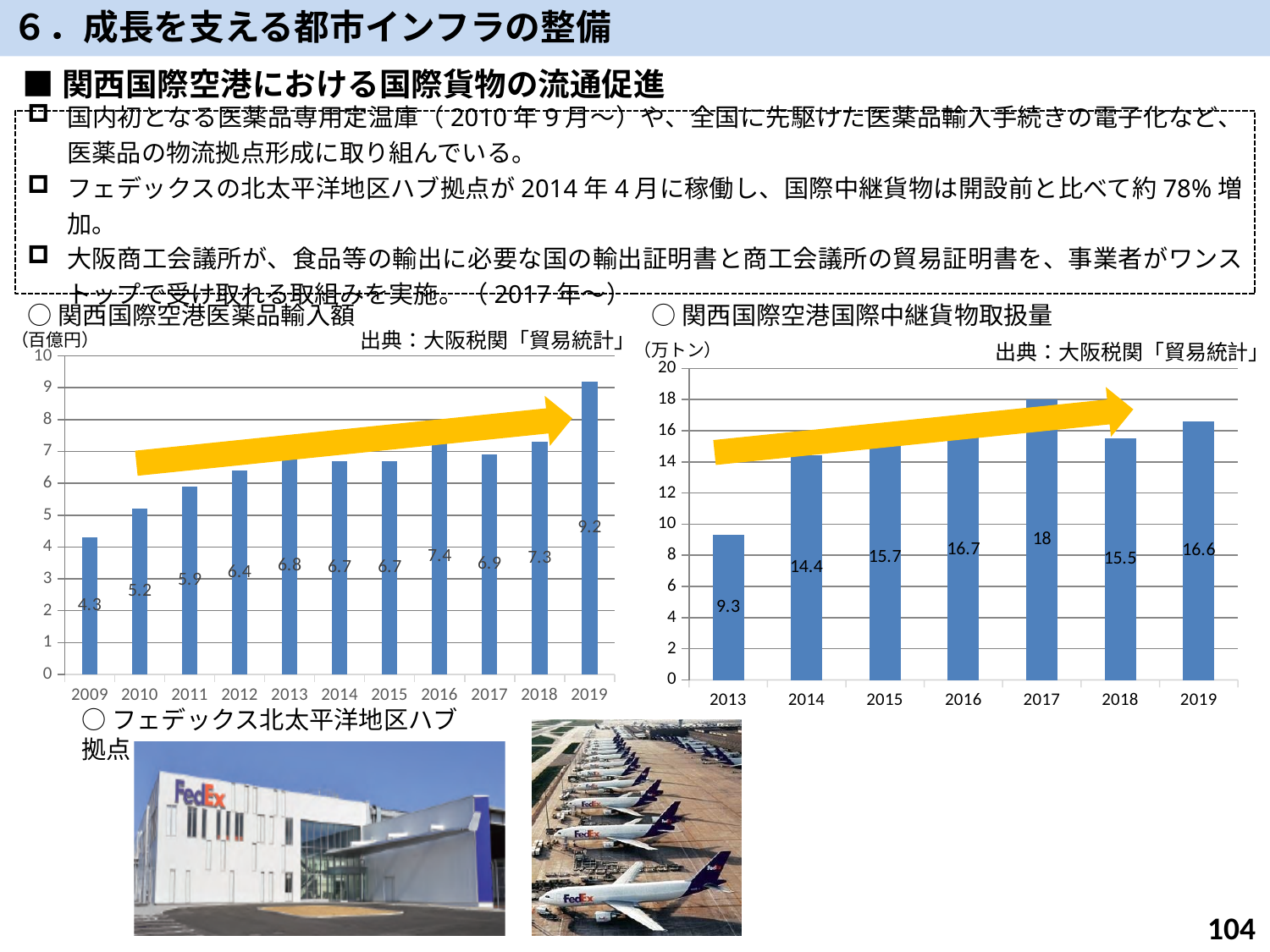
What kind of chart is the 関西国際空港国際中継貨物取扱量 chart? bar chart In the 関西国際空港医薬品輸入額 chart, how many years are plotted? 11 In the 関西国際空港国際中継貨物取扱量 chart, which year has the highest value? 2017 In the 関西国際空港医薬品輸入額 chart, which year has the lowest value? 2009 In the 関西国際空港医薬品輸入額 chart, what is the value for 2019? 9.2 In the 関西国際空港医薬品輸入額 chart, what is the difference between the 2019 value and the 2018 value? 1.9 In the 関西国際空港国際中継貨物取扱量 chart, what is the difference between the 2014 value and the 2013 value? 5.1 In the 関西国際空港医薬品輸入額 chart, what is the value for 2009? 4.3 In the 関西国際空港国際中継貨物取扱量 chart, is the value for 2013 greater or less than 10? less In the 関西国際空港医薬品輸入額 chart, which is larger, the value for 2016 or the value for 2017? 2016 What unit is shown on the vertical axis of the 関西国際空港国際中継貨物取扱量 chart? 万トン In the 関西国際空港国際中継貨物取扱量 chart, what is the value for 2017? 18